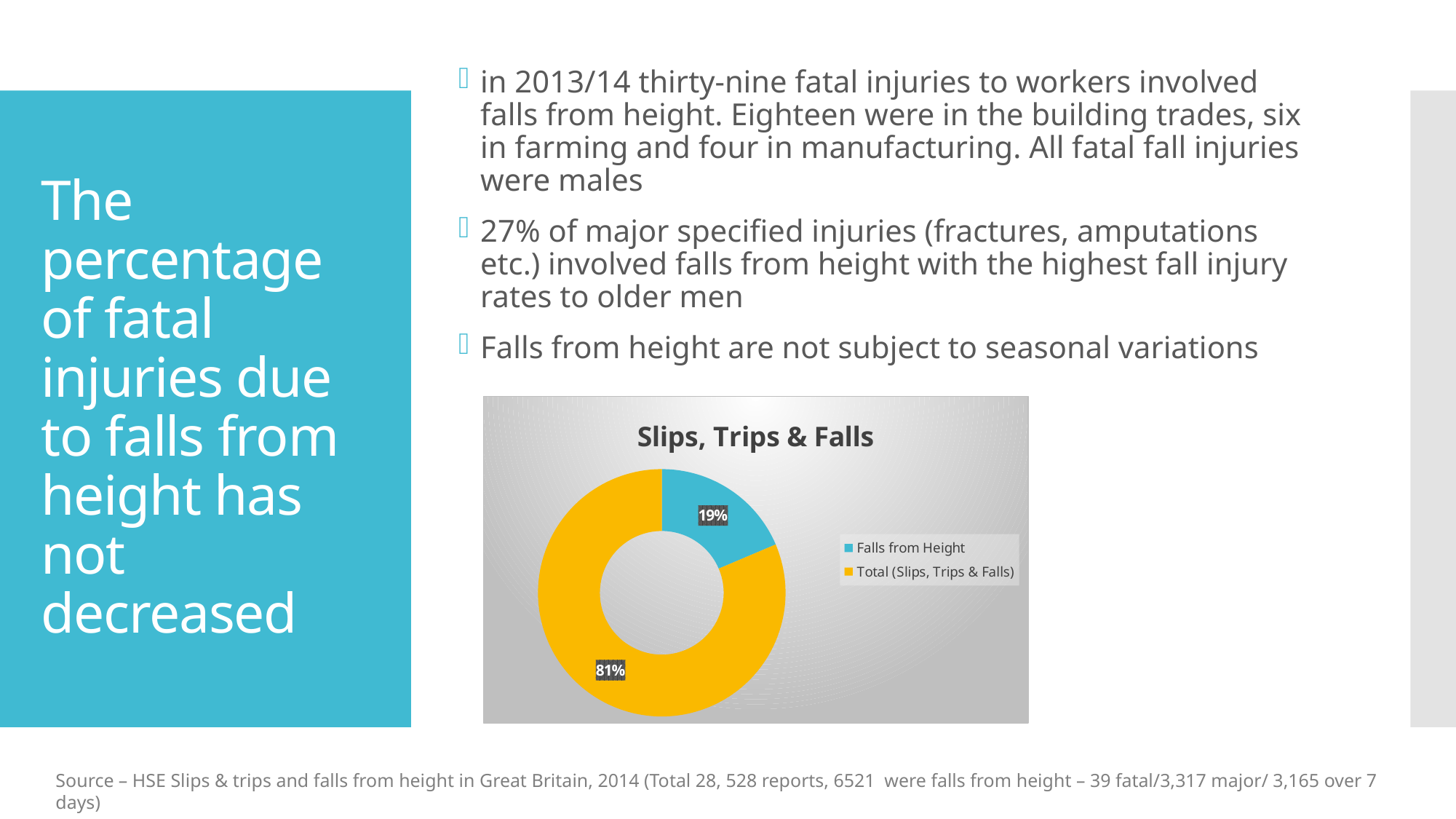
What is the title of the chart on the slide? Slips, Trips & Falls How many slices does the chart have? 2 Which is larger, the Falls from Height slice or the Total (Slips, Trips & Falls) slice? Total (Slips, Trips & Falls) Which slice is the smallest in the chart? Falls from Height What colour is the Falls from Height slice? Blue How many entries does the chart legend list? 2 What kind of chart is shown on the slide? Doughnut (pie) chart What share of the chart does the Falls from Height slice represent? 19% What percentage does the Total (Slips, Trips & Falls) slice show? 81% Which slice is the largest in the chart? Total (Slips, Trips & Falls) What is the difference in percentage points between the Total (Slips, Trips & Falls) slice and the Falls from Height slice? 62 What percentage does the Falls from Height slice show? 19%